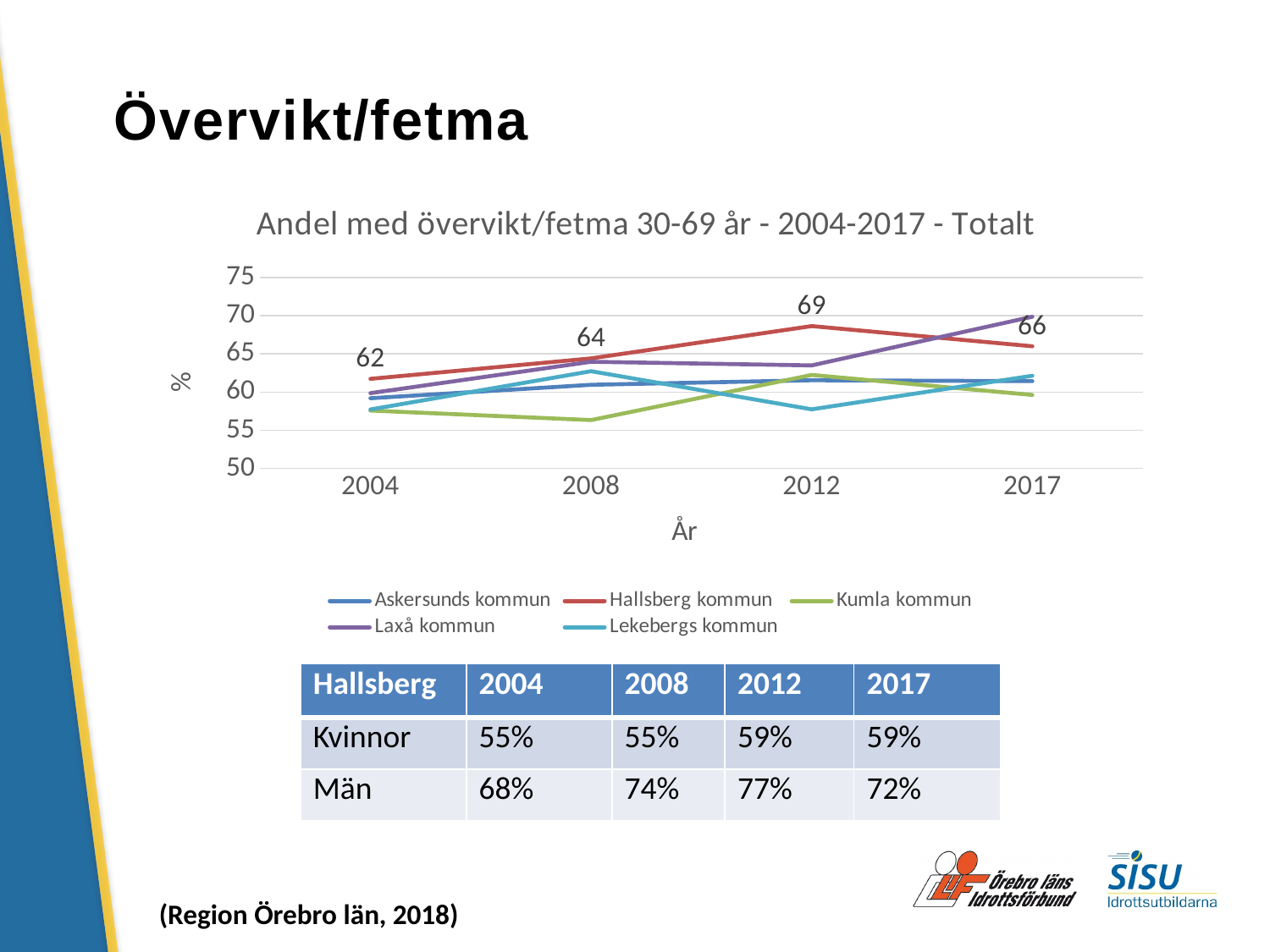
What kind of chart is shown on the slide? line chart What is the title of the chart? Andel med övervikt/fetma 30-69 år - 2004-2017 - Totalt In which year is the value for Hallsberg kommun lowest? 2004 Is the value for Kumla kommun in 2008 greater or less than 60? less What is the value for Hallsberg kommun in 2004? 62 Does the value for Hallsberg kommun rise or fall from 2012 to 2017? fall What is the difference between the Hallsberg kommun values for 2012 and 2004? 7 What is the value for Hallsberg kommun in 2017? 66 What is the value for Hallsberg kommun in 2012? 69 How many years are shown on the x axis of the chart? 4 How many series does the chart legend list? 5 In which year is the value for Hallsberg kommun highest? 2012